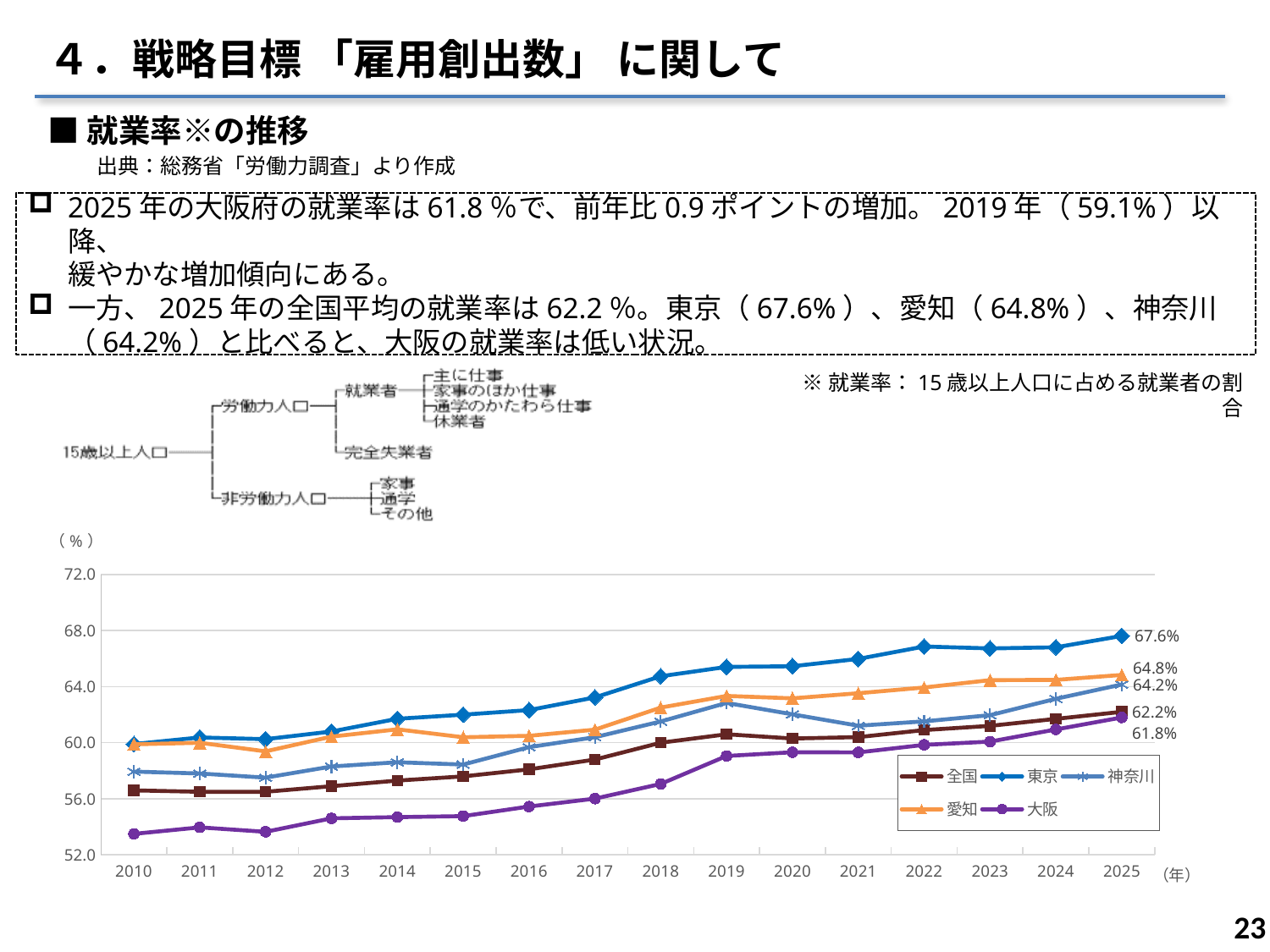
Is the value for 東京 in 2019 greater or less than 64.0? greater What is the 2025 employment rate for 大阪 shown on the chart? 61.8% What is the 2025 value for 全国 on the chart? 62.2% What kind of chart is shown on the slide? line chart How many series does the chart legend list? 5 Which series has the lowest value in 2025? 大阪 Is the value for 大阪 in 2010 greater or less than 56.0? less What is the 2025 employment rate for 東京 shown on the chart? 67.6% How many years are shown on the x axis of the chart? 16 In 2025, which is larger: the value for 愛知 or the value for 神奈川? 愛知 What is the difference between the 2025 values for 東京 and 大阪? 5.8 Which series has the highest value in 2025? 東京